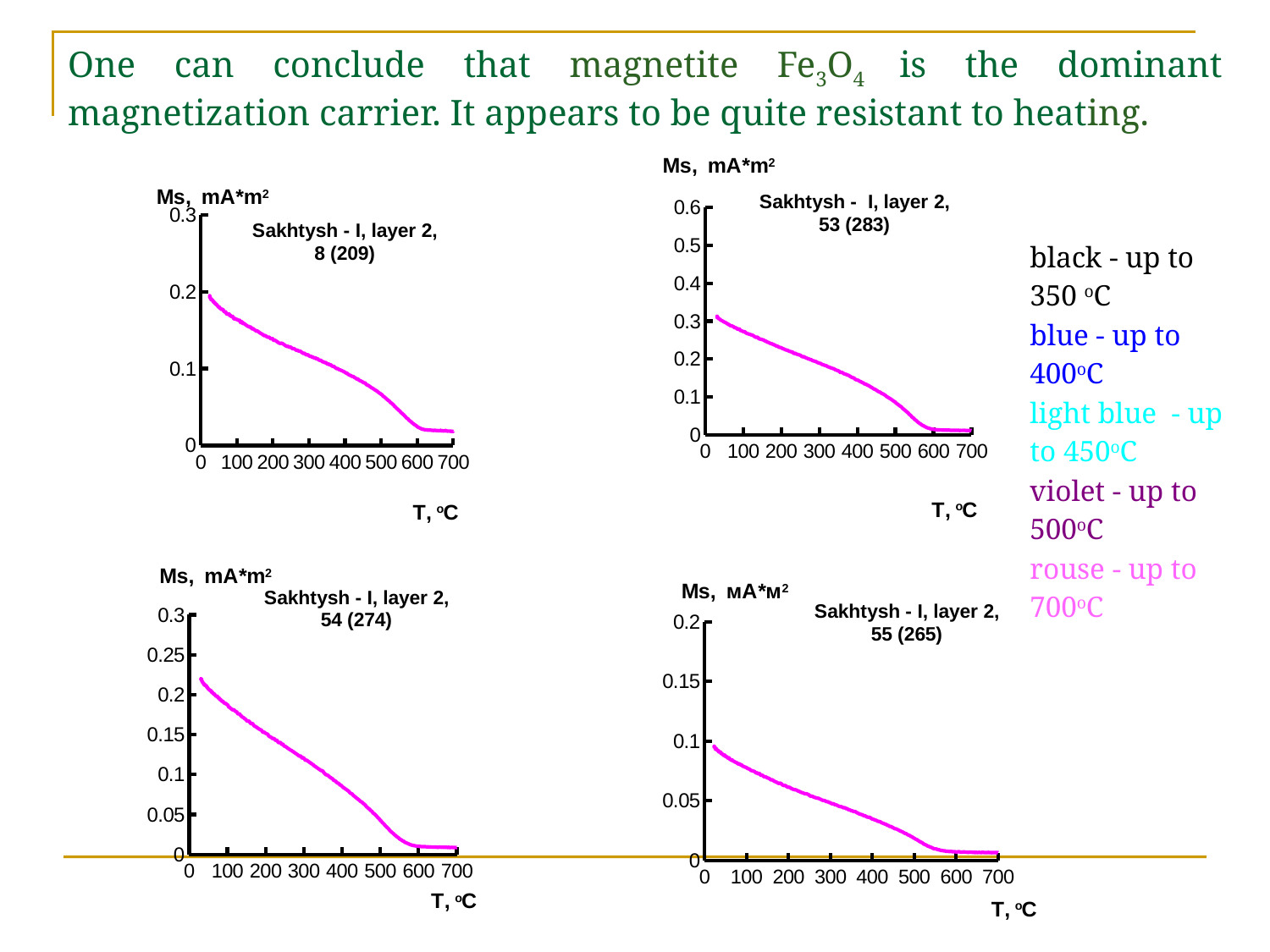
In the 'Sakhtysh - I, layer 2, 54 (274)' chart, is the Ms value at T = 100 °C greater or less than 0.15? greater How many charts are shown on the slide? 4 In the 'Sakhtysh - I, layer 2, 53 (283)' chart, is the Ms value at T = 600 °C greater or less than 0.1? less In the 'Sakhtysh - I, layer 2, 8 (209)' chart, is the Ms value at T = 600 °C greater or less than 0.1? less What is the highest value shown on the y axis of the 'Sakhtysh - I, layer 2, 53 (283)' chart? 0.6 What kind of chart is the 'Sakhtysh - I, layer 2, 8 (209)' chart? line chart In the 'Sakhtysh - I, layer 2, 53 (283)' chart, do the Ms values rise or fall as T increases along the x axis? fall Which chart has the larger starting Ms value at the lowest temperature: 'Sakhtysh - I, layer 2, 8 (209)' or 'Sakhtysh - I, layer 2, 53 (283)'? Sakhtysh - I, layer 2, 53 (283)